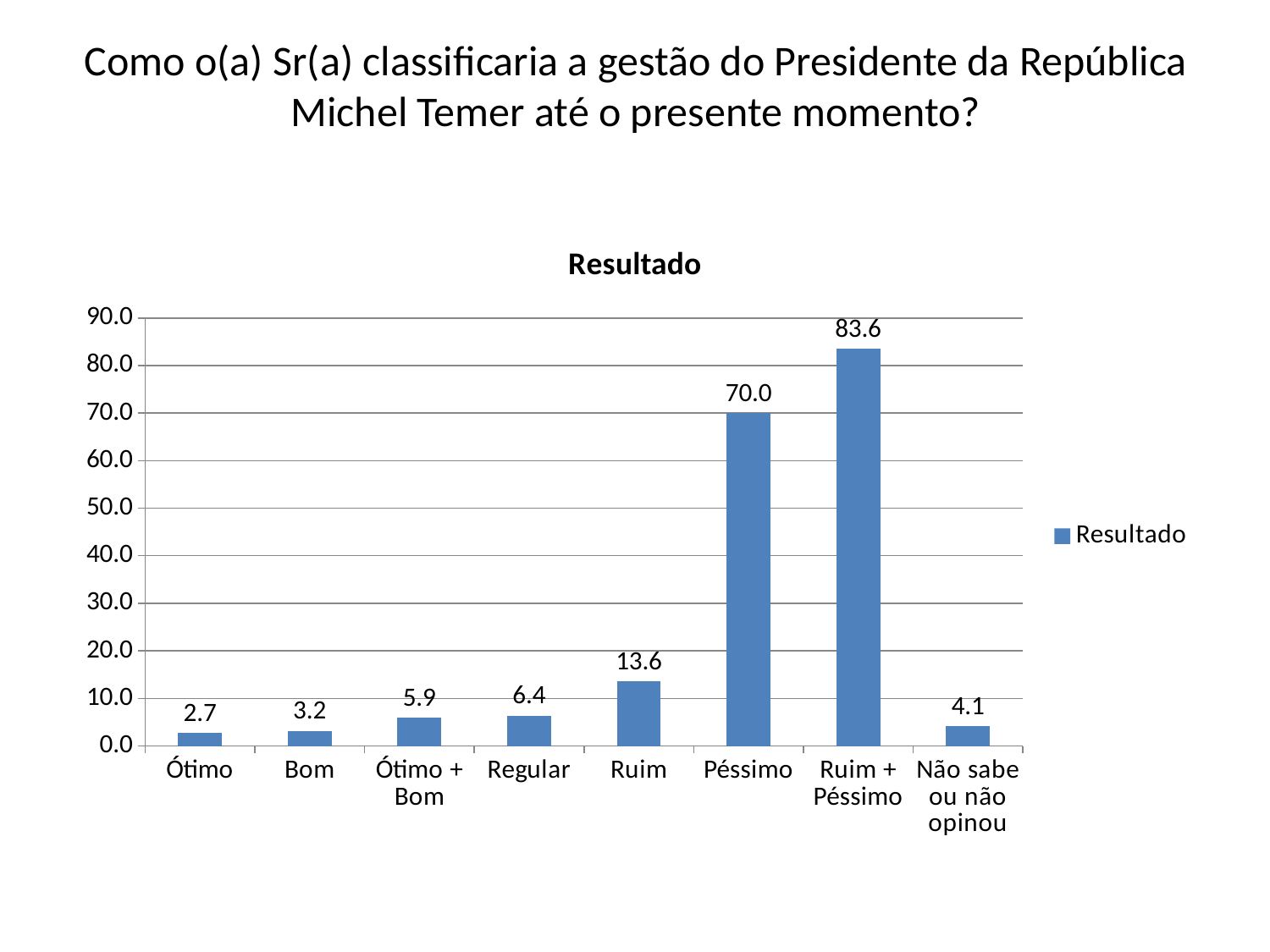
Which category has the lowest value? Ótimo What is the value for Ruim? 13.6 How many series does the legend list? 1 Which category has the highest value? Ruim + Péssimo What is the value for Não sabe ou não opinou? 4.1 What is the title of the chart? Resultado What is the difference between the values for Ruim + Péssimo and Péssimo? 13.6 Is the value for Ruim greater or less than 10.0? greater What is the value for Péssimo? 70.0 What kind of chart is shown? bar chart How many categories are shown on the x axis? 8 Which is larger, the value for Regular or the value for Ótimo + Bom? Regular